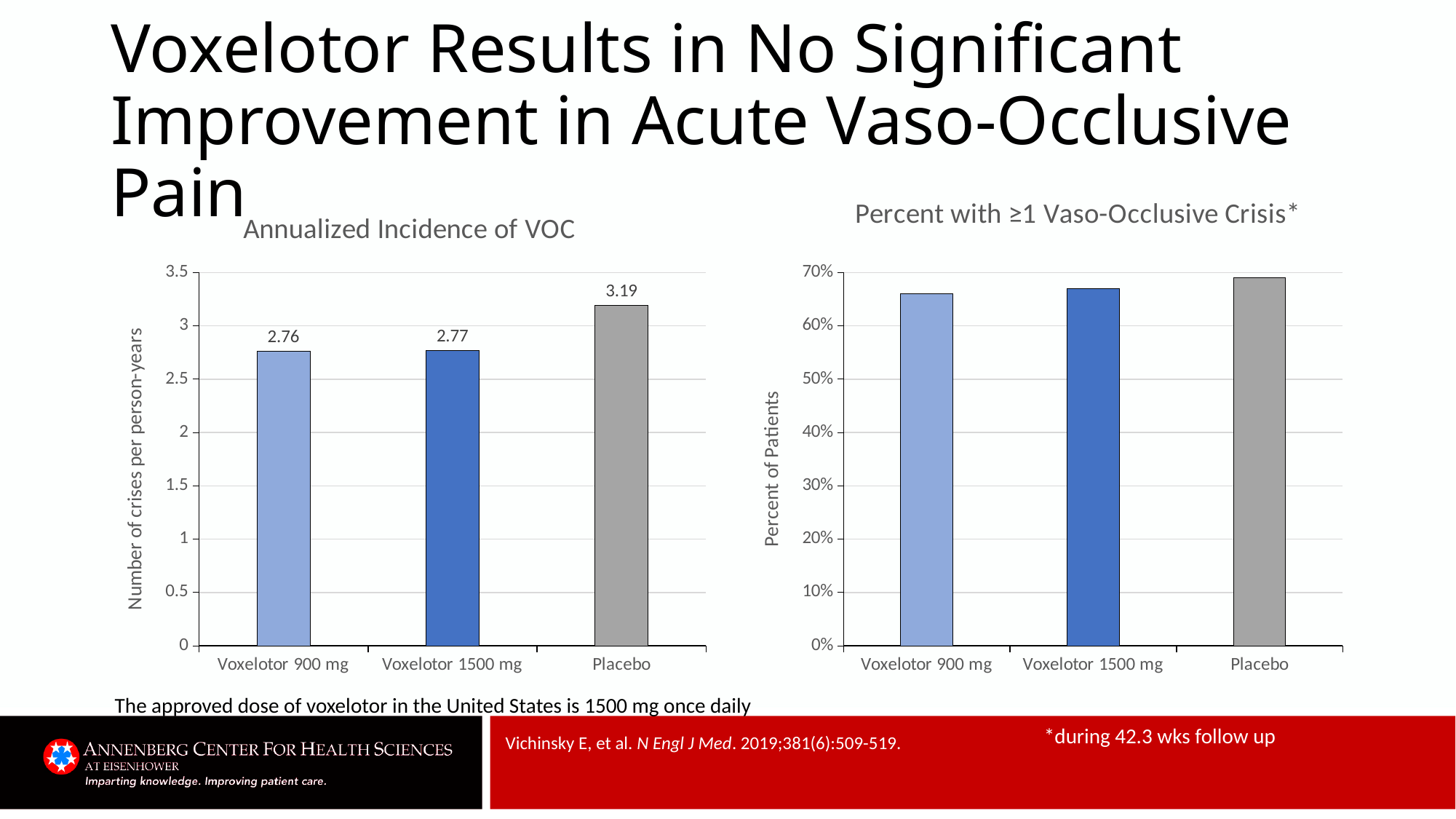
What type of chart is the Percent with ≥1 Vaso-Occlusive Crisis chart? Bar chart In the Annualized Incidence of VOC chart, what is the value for Voxelotor 1500 mg? 2.77 In the Annualized Incidence of VOC chart, what is the value for Voxelotor 900 mg? 2.76 In the Annualized Incidence of VOC chart, what is the difference between the Placebo value and the Voxelotor 900 mg value? 0.43 In the Annualized Incidence of VOC chart, which group has the highest number of crises per person-years? Placebo In the Percent with ≥1 Vaso-Occlusive Crisis chart, which group has the highest percent of patients? Placebo In the Percent with ≥1 Vaso-Occlusive Crisis chart, is the value for Voxelotor 900 mg greater or less than 60%? greater In the Annualized Incidence of VOC chart, which is larger, the value for Placebo or the value for Voxelotor 1500 mg? Placebo How many groups are shown in the Annualized Incidence of VOC chart? 3 What is the y-axis label of the Annualized Incidence of VOC chart? Number of crises per person-years In the Annualized Incidence of VOC chart, what is the value for Placebo? 3.19 In the Annualized Incidence of VOC chart, what is the difference between the Placebo value and the Voxelotor 1500 mg value? 0.42